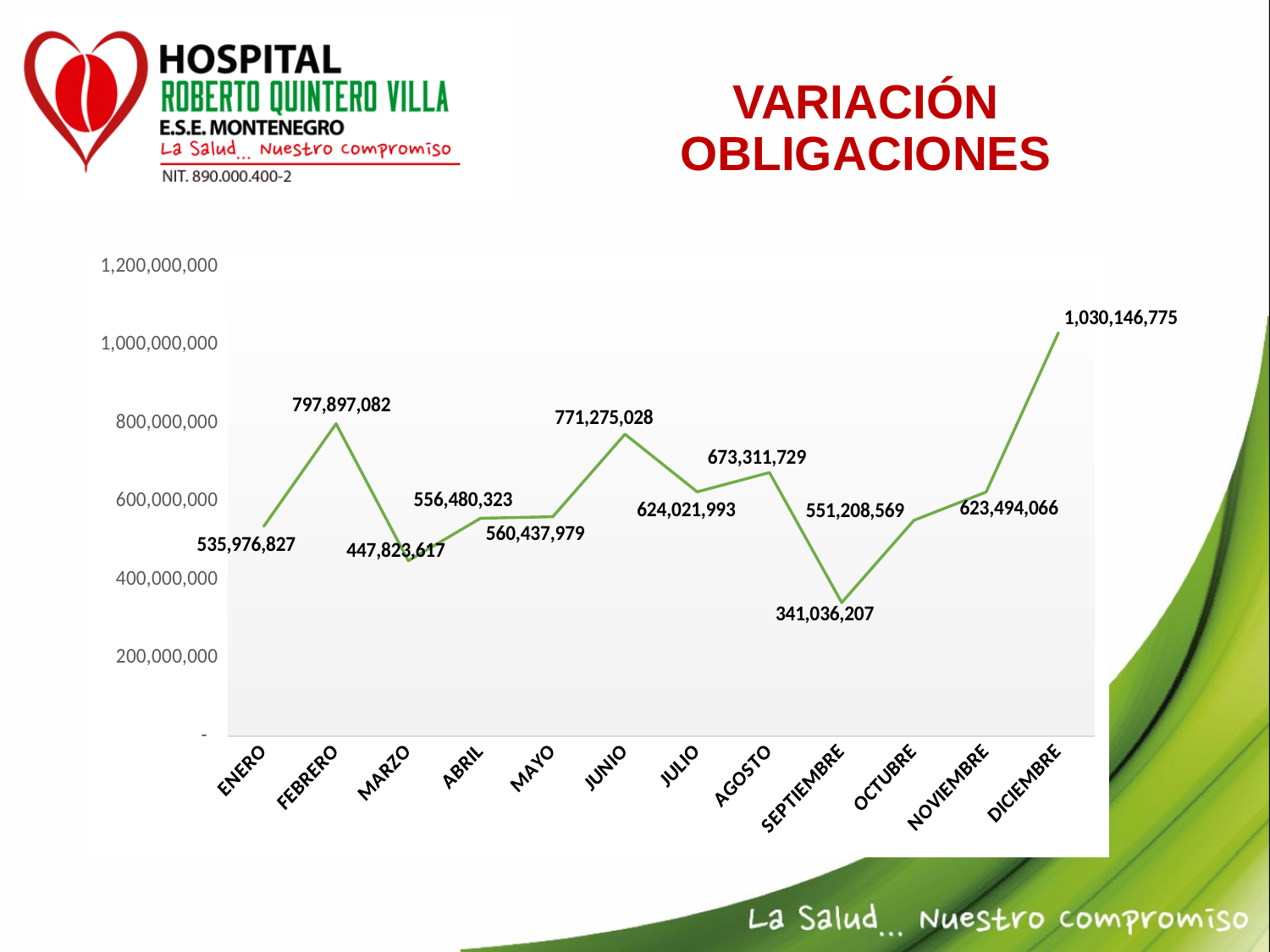
How many months are plotted on the chart? 12 Which month has the lowest value? SEPTIEMBRE Which is larger, the value for JUNIO or the value for AGOSTO? JUNIO Is the value for MARZO greater or less than 600,000,000? less What kind of chart is shown on the slide? line chart Which month has the highest value? DICIEMBRE Do the values rise or fall from SEPTIEMBRE to DICIEMBRE? rise What is the value for FEBRERO? 797,897,082 What is the value for DICIEMBRE? 1,030,146,775 What is the difference between the values for DICIEMBRE and SEPTIEMBRE? 689,110,568 What is the difference between the values for FEBRERO and ENERO? 261,920,255 What is the value for SEPTIEMBRE? 341,036,207